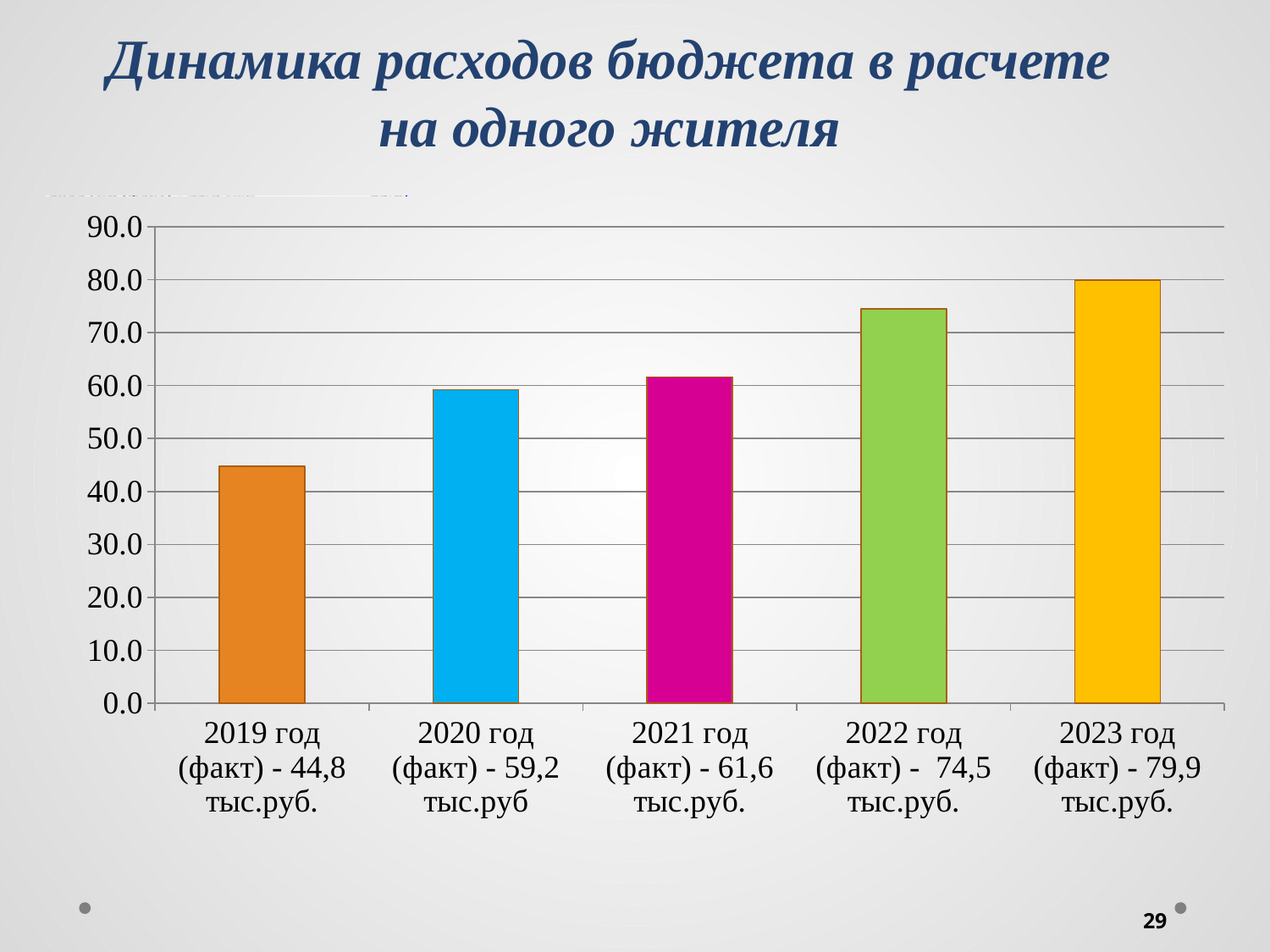
What kind of chart is shown on the slide? bar chart Is the value for 2021 год greater or less than 60.0? greater Which year has the lowest value? 2019 год What is the difference between the values for 2021 год and 2020 год? 2,4 тыс.руб. What is the value for 2023 год? 79,9 тыс.руб. Which year has the highest value? 2023 год What is the value for 2019 год? 44,8 тыс.руб. Which is larger, the value for 2020 год or the value for 2022 год? 2022 год Do the values rise or fall from 2019 год to 2023 год? rise What is the difference between the values for 2023 год and 2019 год? 35,1 тыс.руб. How many years are shown on the chart? 5 What is the value for 2022 год? 74,5 тыс.руб.